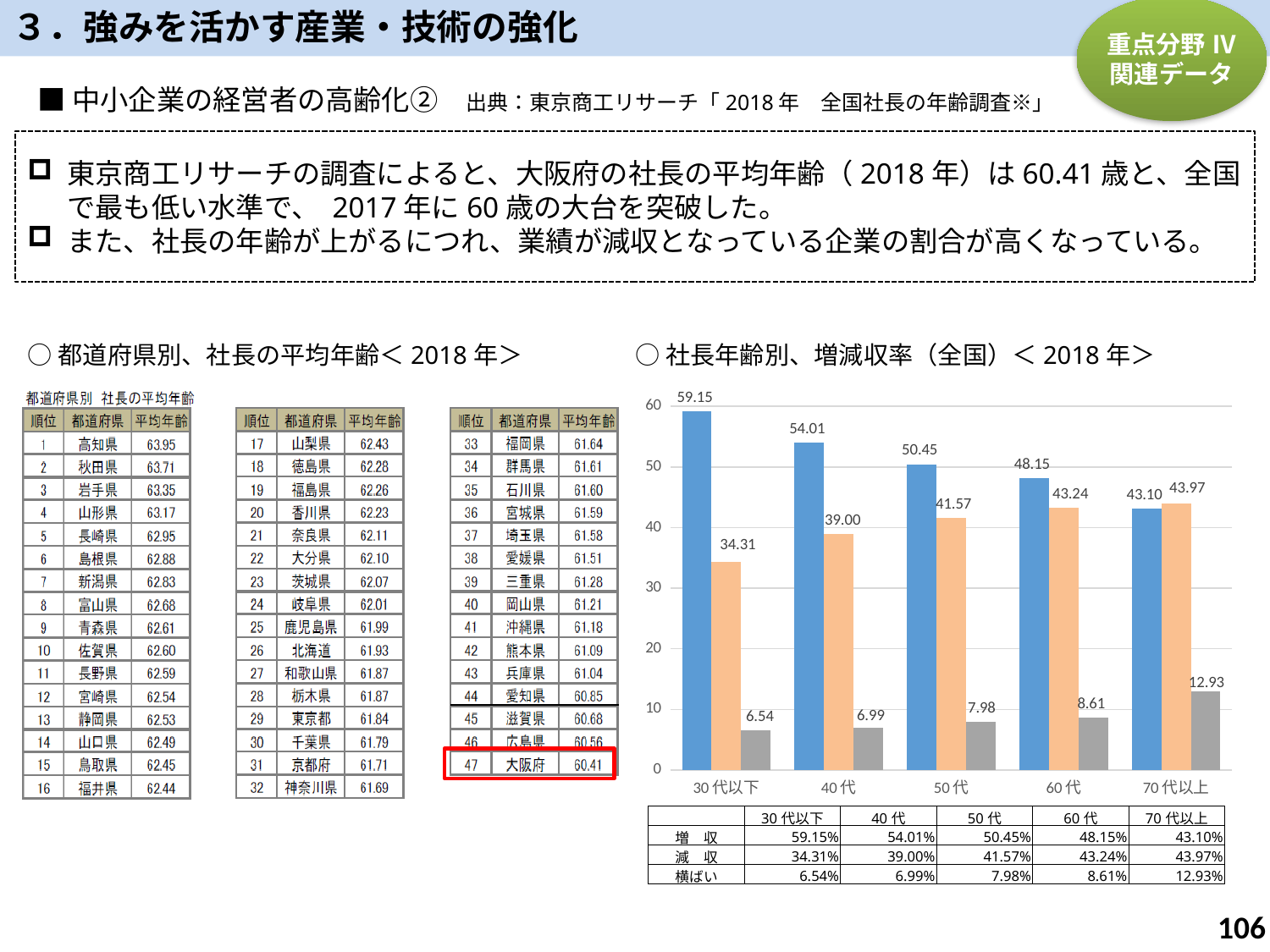
In the chart 社長年齢別、増減収率（全国）＜2018年＞, which age group has the highest 増収 value? 30代以下 In the chart 社長年齢別、増減収率（全国）＜2018年＞, how many age-group categories are shown on the x axis? 5 In the chart 社長年齢別、増減収率（全国）＜2018年＞, what is the 増収 value for 30代以下? 59.15 In the chart 社長年齢別、増減収率（全国）＜2018年＞, for 70代以上, which is larger: 増収 or 減収? 減収 In the chart 社長年齢別、増減収率（全国）＜2018年＞, for 60代, which is larger: 増収 or 減収? 増収 What kind of chart is 社長年齢別、増減収率（全国）＜2018年＞? Bar chart In the chart 社長年齢別、増減収率（全国）＜2018年＞, what is the 横ばい value for 70代以上? 12.93 In the chart 社長年齢別、増減収率（全国）＜2018年＞, does the 増収 value rise or fall as the age group increases from 30代以下 to 70代以上? Fall In the chart 社長年齢別、増減収率（全国）＜2018年＞, what is the 減収 value for 50代? 41.57 In the chart 社長年齢別、増減収率（全国）＜2018年＞, what is the difference between the 増収 and 減収 values for 40代? 15.01 In the chart 社長年齢別、増減収率（全国）＜2018年＞, how many data series are plotted? 3 In the chart 社長年齢別、増減収率（全国）＜2018年＞, which age group has the lowest 横ばい value? 30代以下